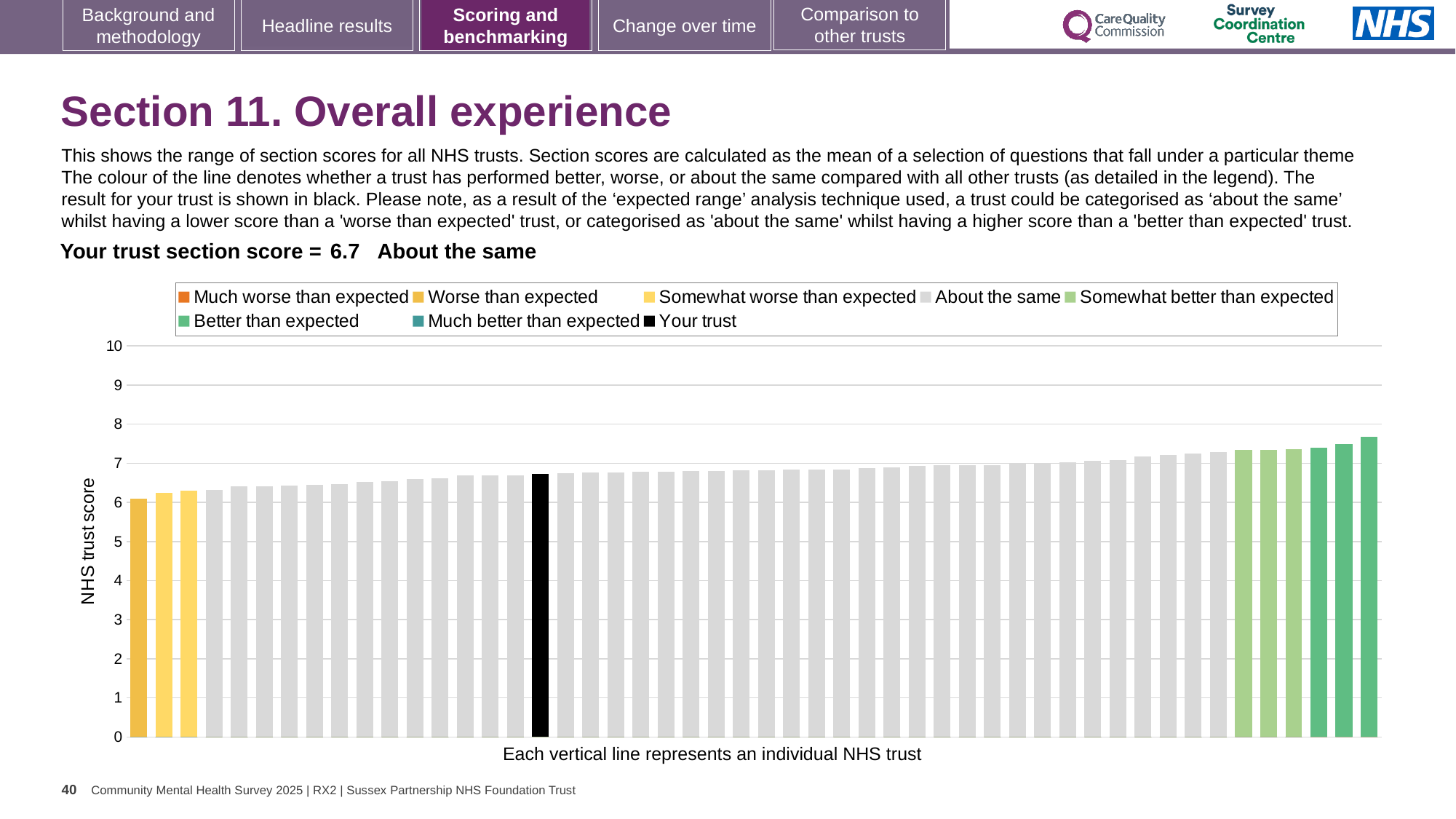
Is the value of the highest bar greater or less than 8? less What is the section score for your trust shown on the slide? 6.7 Is the value for your trust (the black bar) greater or less than 5? greater Do the bar values rise or fall from left to right along the x axis? rise Is the value of the lowest (leftmost) bar greater or less than 7? less What kind of chart is shown on the slide? bar chart What is the label on the vertical axis of the chart? NHS trust score What colour does the legend use for 'Your trust'? black Which category is your trust placed in for Section 11 Overall experience? About the same How many entries does the chart legend list? 8 How many bars on the chart are coloured black? 1